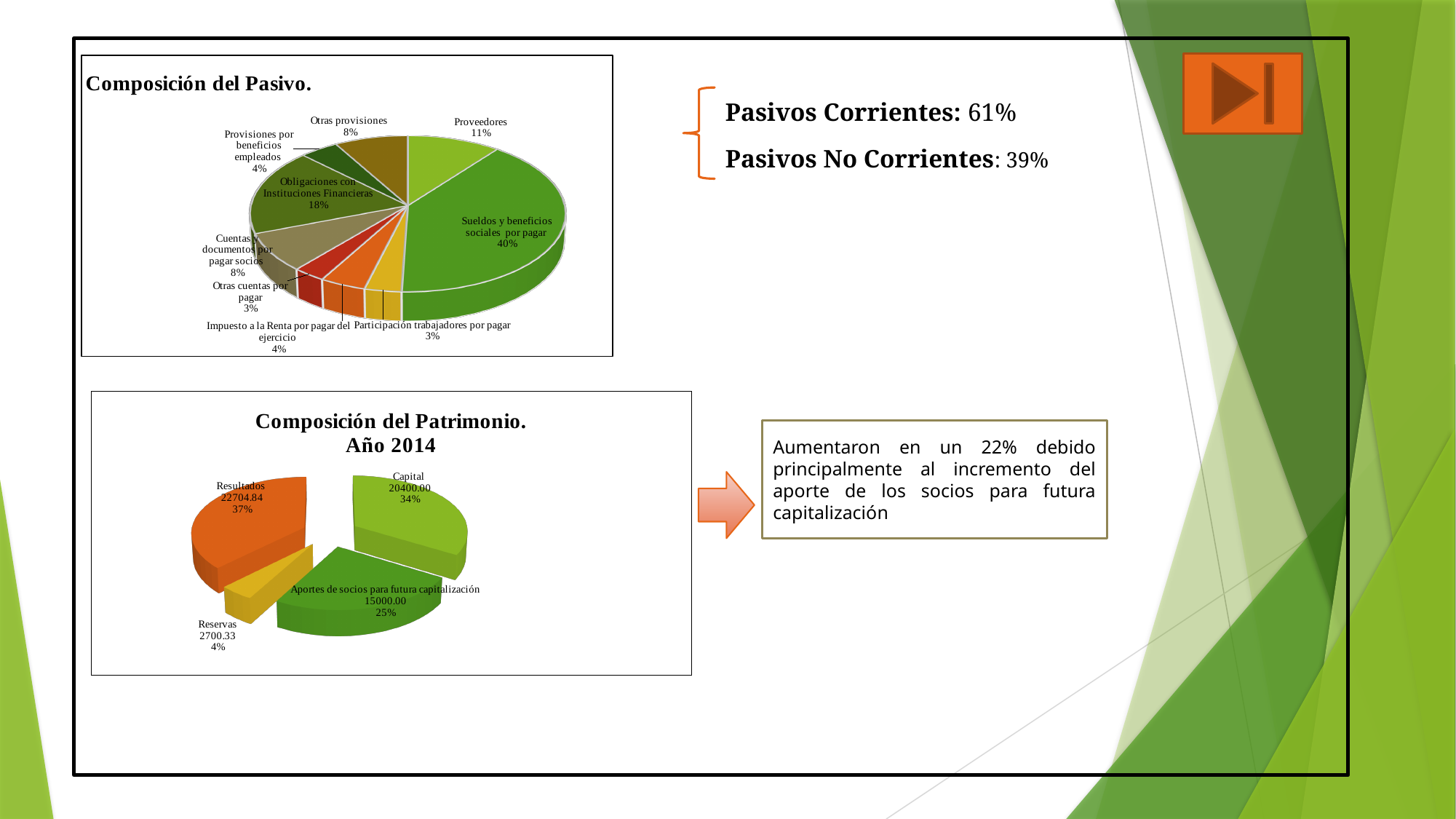
In the 'Composición del Pasivo.' chart, what is the difference in percentage points between 'Proveedores' and 'Otras provisiones'? 3 In the 'Composición del Patrimonio. Año 2014' chart, what share does 'Aportes de socios para futura capitalización' represent? 25% In the 'Composición del Pasivo.' chart, how many slices does the pie have? 9 In the 'Composición del Patrimonio. Año 2014' chart, how many categories are shown? 4 In the 'Composición del Patrimonio. Año 2014' chart, what is the difference between the values of 'Capital' and 'Aportes de socios para futura capitalización'? 5400.00 In the 'Composición del Patrimonio. Año 2014' chart, what is the value for 'Resultados'? 22704.84 In the 'Composición del Pasivo.' chart, what percentage is shown for 'Obligaciones con Instituciones Financieras'? 18% What kind of chart is 'Composición del Patrimonio. Año 2014'? Pie chart In the 'Composición del Pasivo.' chart, which category has the largest slice? Sueldos y beneficios sociales por pagar In the 'Composición del Patrimonio. Año 2014' chart, which category has the smallest slice? Reservas In the 'Composición del Pasivo.' chart, which is larger: 'Cuentas y documentos por pagar socios' or 'Otras cuentas por pagar'? Cuentas y documentos por pagar socios In the 'Composición del Pasivo.' chart, what share does 'Sueldos y beneficios sociales por pagar' represent? 40%